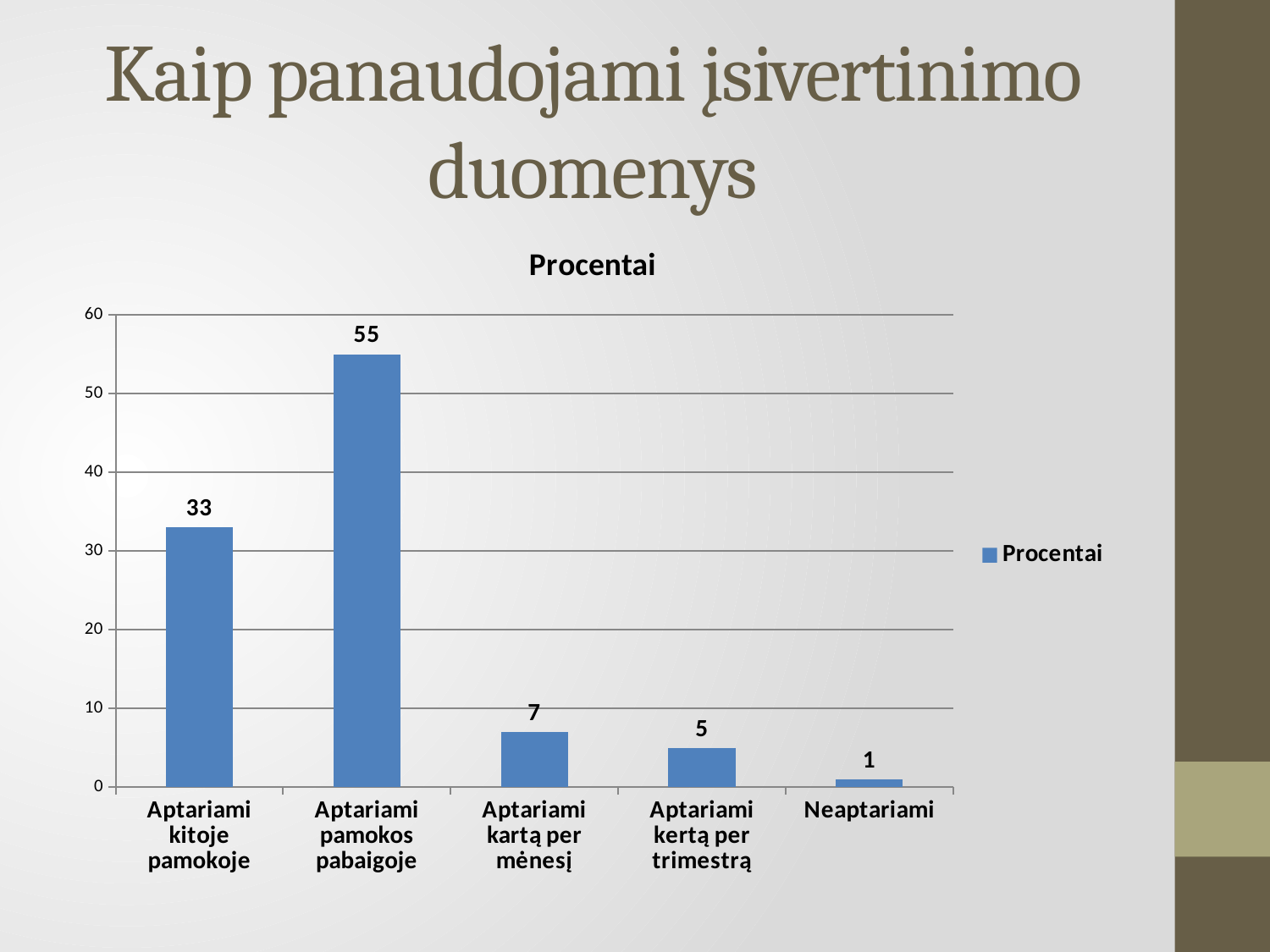
What is the value for "Aptariami pamokos pabaigoje"? 55 What kind of chart is shown on the slide? bar chart How many categories are shown on the x axis? 5 What is the title of the chart? Procentai Which category has the lowest value? Neaptariami What is the difference between the values for "Aptariami pamokos pabaigoje" and "Aptariami kitoje pamokoje"? 22 What is the value for "Neaptariami"? 1 Is the value for "Aptariami kitoje pamokoje" greater or less than 40? less Which category has the highest value? Aptariami pamokos pabaigoje How many series does the legend list? 1 What is the value for "Aptariami kitoje pamokoje"? 33 Which is larger: the value for "Aptariami kartą per mėnesį" or "Aptariami kertą per trimestrą"? Aptariami kartą per mėnesį